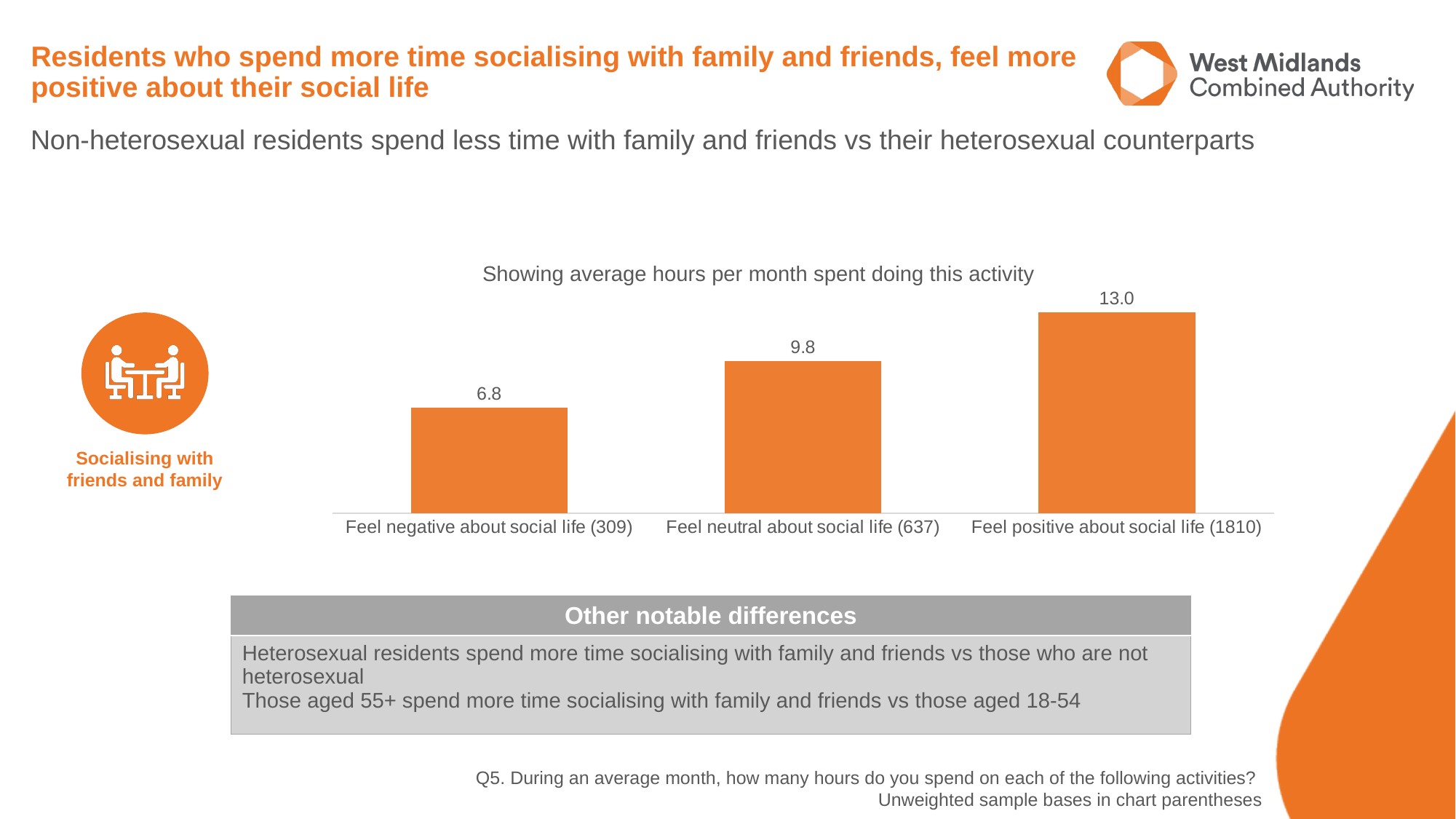
What is the average hours per month for residents who feel positive about social life (1810)? 13.0 What does the chart subtitle say the chart is showing? Showing average hours per month spent doing this activity Which category has the lowest average hours per month? Feel negative about social life (309) What is the average hours per month for residents who feel neutral about social life (637)? 9.8 What is the difference in average hours per month between those who feel positive and those who feel negative about their social life? 6.2 How many categories are shown in the chart? 3 What is the average hours per month for residents who feel negative about social life (309)? 6.8 Do the values rise or fall moving from left to right across the categories? Rise What is the difference in average hours per month between those who feel neutral and those who feel negative about their social life? 3.0 What kind of chart is shown on the slide? Bar chart Which is larger: the value for those who feel neutral about social life or those who feel positive about social life? Feel positive about social life Which category has the highest average hours per month? Feel positive about social life (1810)